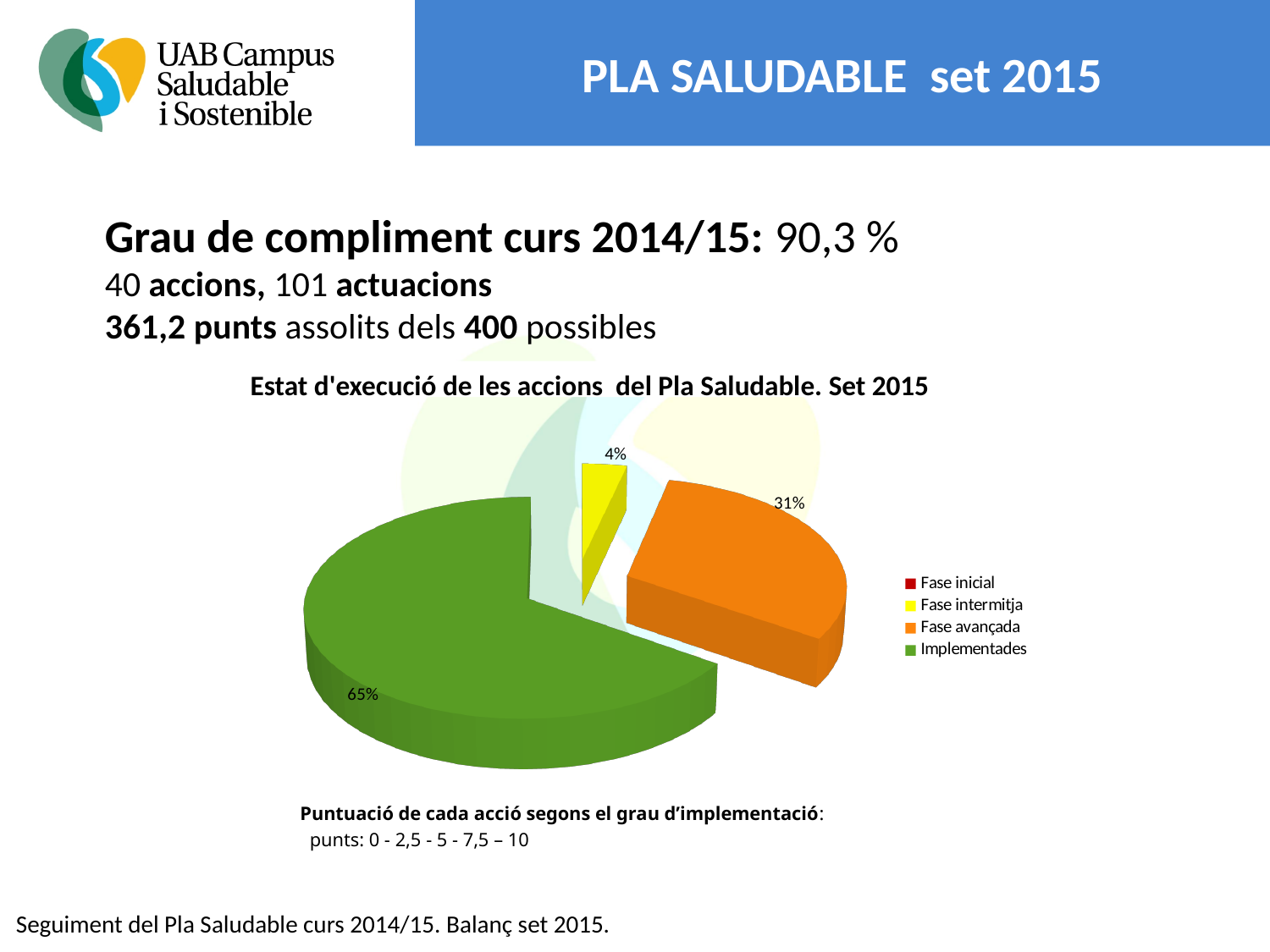
Which category has the largest slice of the pie? Implementades What percentage of the pie corresponds to Implementades? 65% What percentage of the pie corresponds to Fase avançada? 31% What percentage of the pie corresponds to Fase intermitja? 4% How many entries does the chart legend list? 4 Which of the labelled slices is the smallest? Fase intermitja What kind of chart is shown on the slide? Pie chart Which is larger, the Fase avançada slice or the Fase intermitja slice? Fase avançada How many percentage points larger is the Implementades slice than the Fase avançada slice? 34 percentage points What colour is the Implementades slice? Green What is the title of the chart? Estat d'execució de les accions del Pla Saludable. Set 2015 How many percentage points larger is the Fase avançada slice than the Fase intermitja slice? 27 percentage points